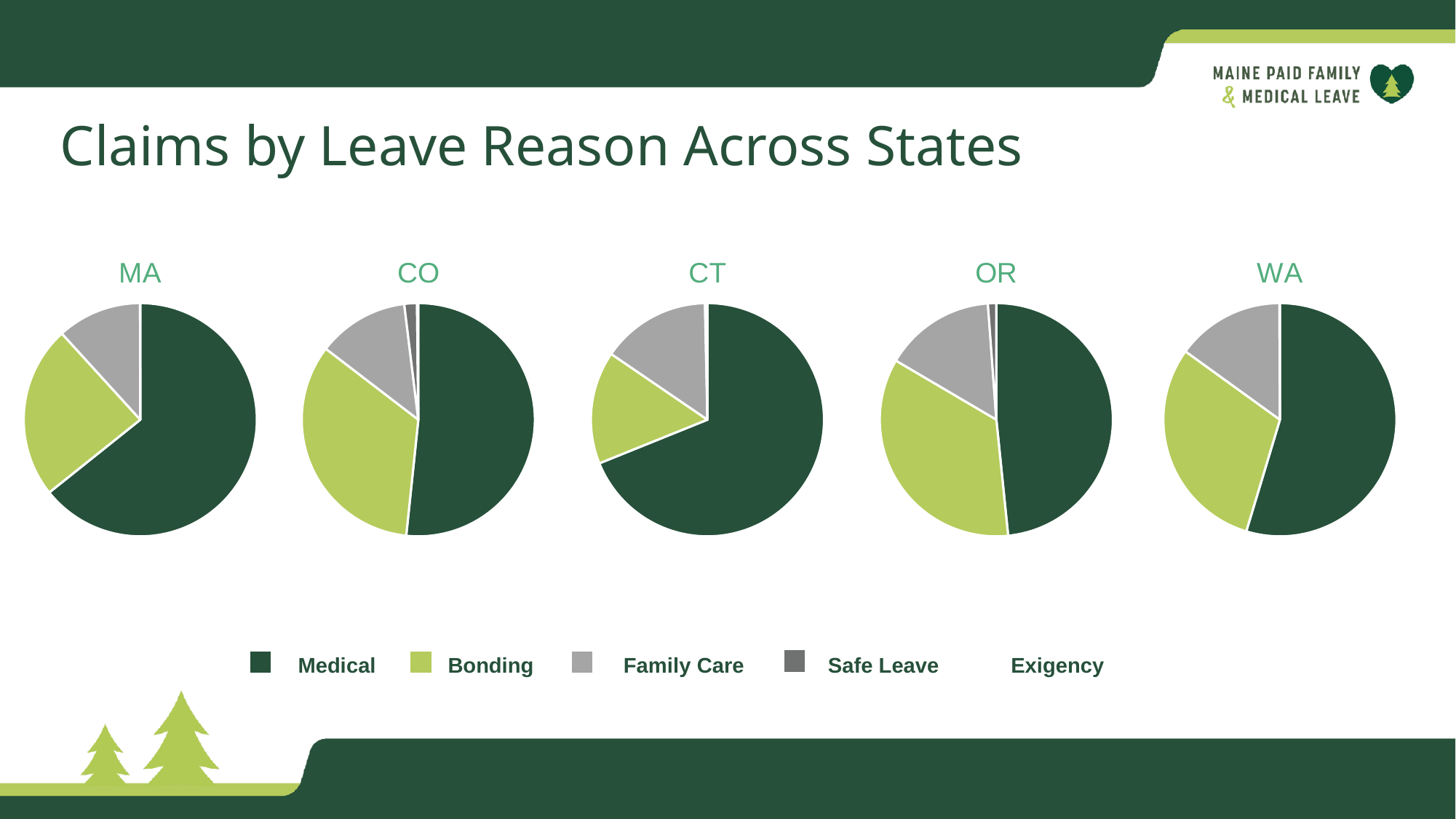
In the WA pie chart, which leave reason has the largest slice? Medical In the CO pie chart, which visible slice is the smallest? Safe Leave In the WA pie chart, which slice is larger, Bonding or Family Care? Bonding What is the title of the slide containing the pie charts? Claims by Leave Reason Across States In the MA pie chart, which slice is larger, Bonding or Family Care? Bonding What kind of charts are shown on the slide? Pie charts In the MA pie chart, which leave reason has the largest slice? Medical How many pie charts (states) are shown on the slide? 5 How many leave reasons does the legend list? 5 In the CT pie chart, which leave reason has the largest slice? Medical In the OR pie chart, which visible slice is the smallest? Safe Leave In the CO pie chart, which slice is larger, Medical or Bonding? Medical